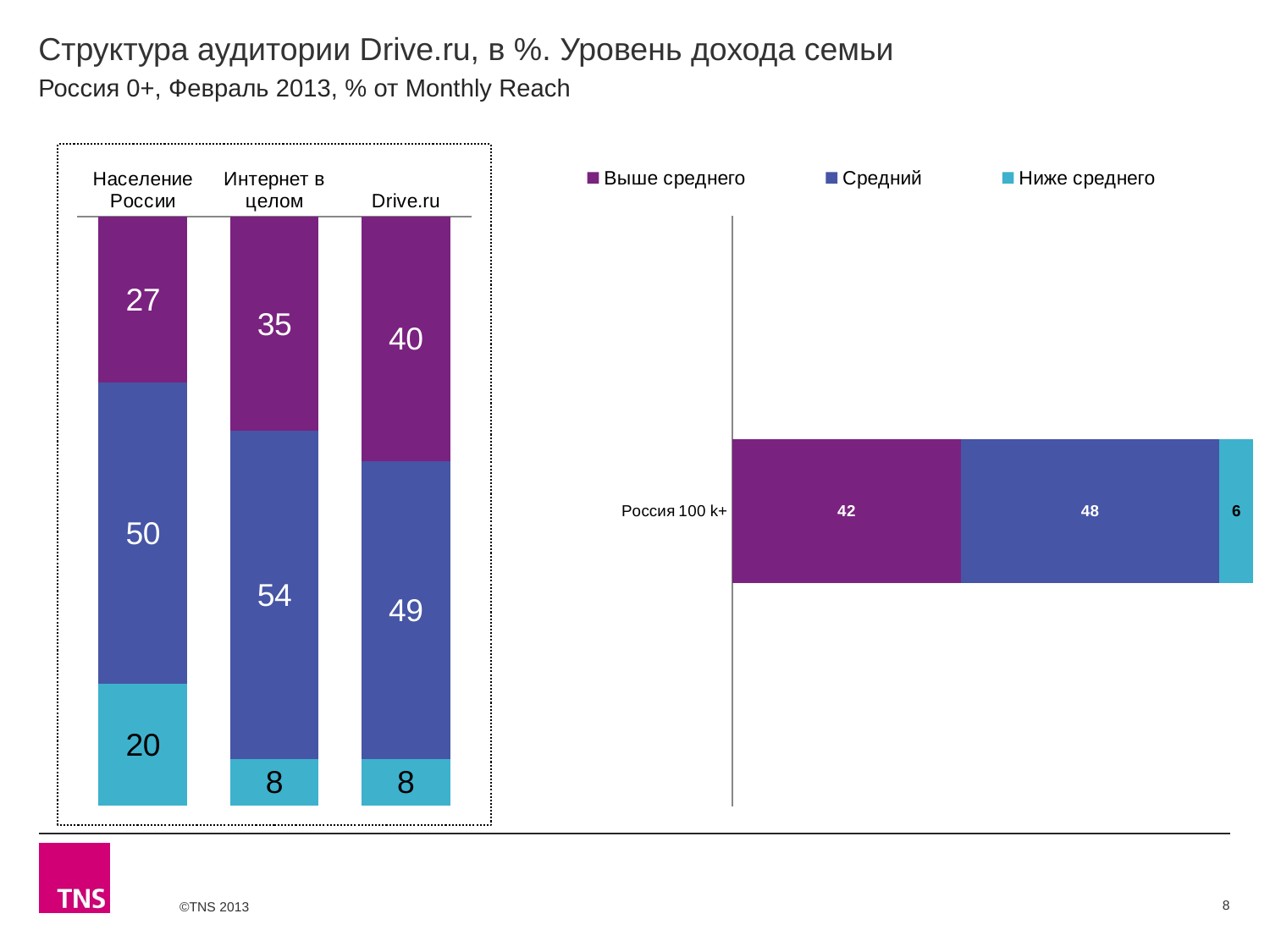
In the left chart, which is larger: the 'Ниже среднего' value for 'Население России' or for 'Интернет в целом'? Население России How many series does the legend list? 3 In the right chart, what is the value of the 'Средний' segment for 'Россия 100 k+'? 48 In the left chart, what is the value of the 'Ниже среднего' segment for 'Население России'? 20 In the left chart, which category has the lowest 'Средний' value? Drive.ru What type of chart is the right chart? Stacked bar chart In the left chart, what is the value of the 'Выше среднего' segment for 'Интернет в целом'? 35 In the left chart, what is the difference between the 'Выше среднего' values for 'Drive.ru' and 'Население России'? 13 In the left chart, what is the value of the 'Средний' segment for 'Drive.ru'? 49 In the right chart, what is the total of the stacked bar for 'Россия 100 k+'? 96 In the left chart, which category has the highest 'Выше среднего' value? Drive.ru How many categories are shown in the left chart? 3